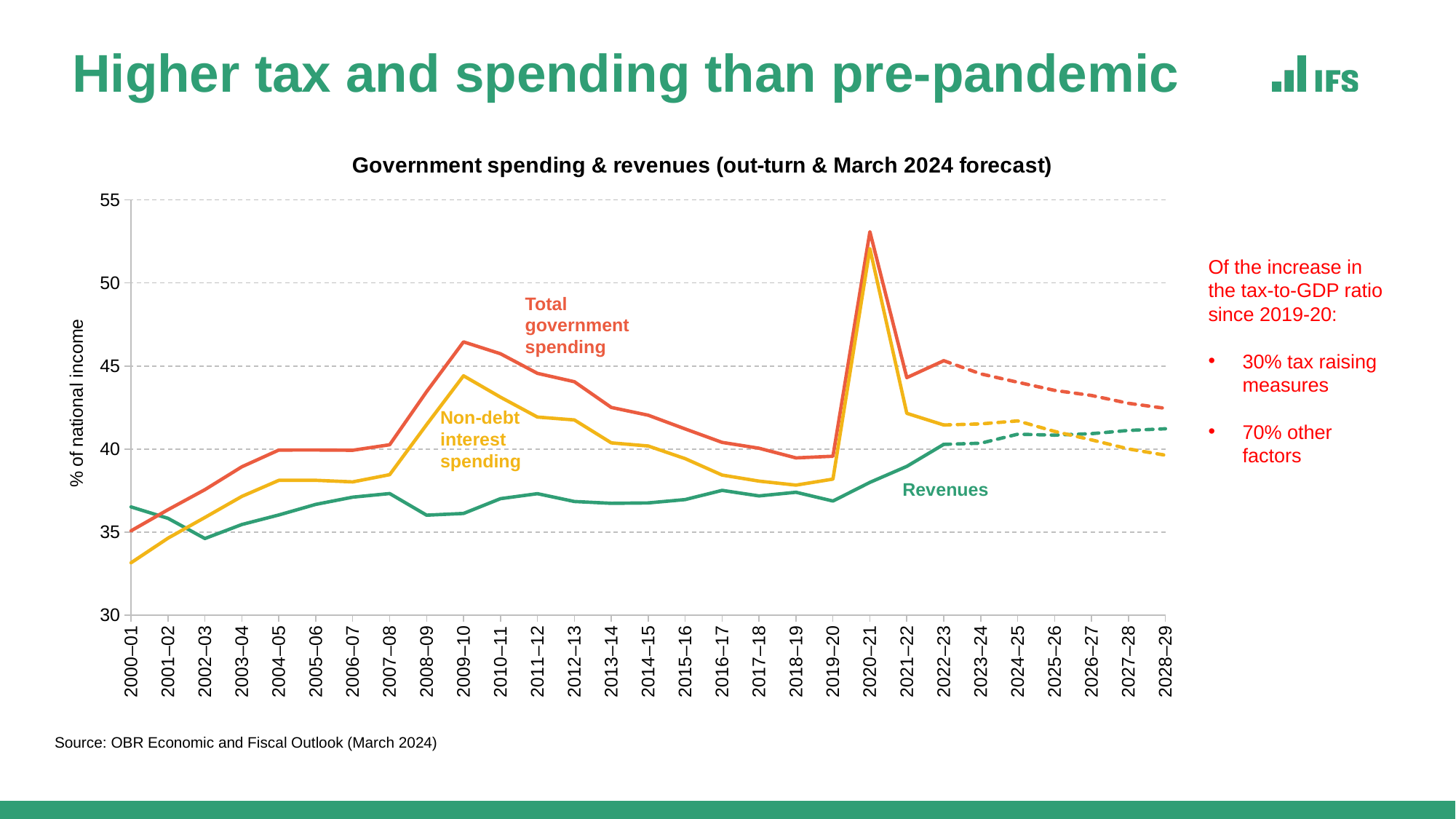
How many years are shown along the x axis of the chart? 29 What is the label on the y axis of the chart? % of national income Is the value for Total government spending in 2020–21 greater or less than 50? greater In 2000–01, which is higher: Revenues or Total government spending? Revenues Is the value for Revenues in 2002–03 greater or less than 35? less Is the value for Non-debt interest spending in 2000–01 greater or less than 35? less How many series are plotted on the chart? 3 In 2009–10, which is higher: Total government spending or Revenues? Total government spending Does Total government spending rise or fall from 2022–23 to 2028–29? fall In which year does Total government spending reach its highest value? 2020–21 What kind of chart is shown on the slide? line chart In which year is Revenues at its lowest value? 2002–03